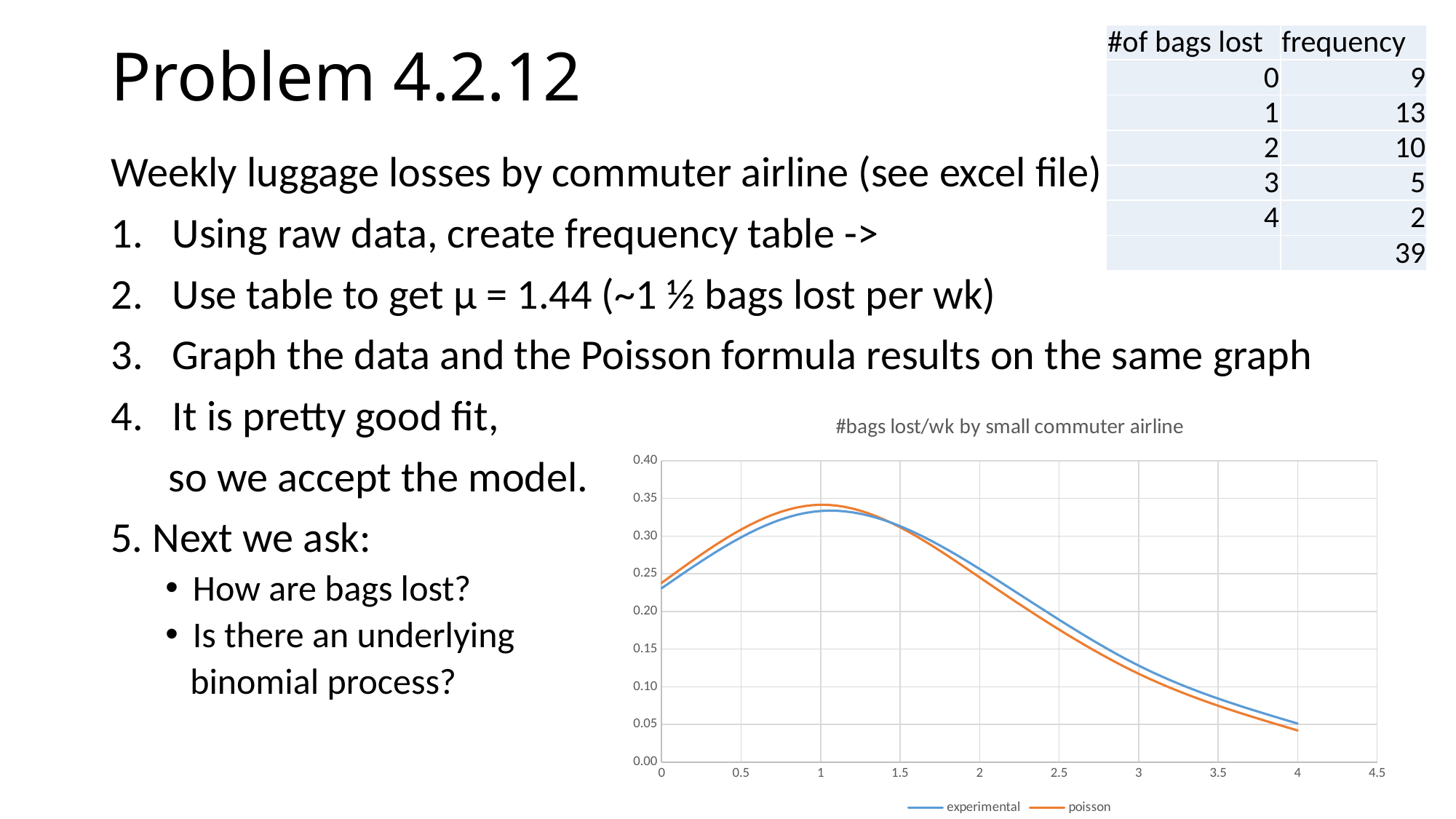
Do the values of the experimental series rise or fall between x = 1 and x = 4? fall Is the value of the experimental series at x = 4 greater or less than 0.10? less Is the value of the experimental series at x = 1 greater or less than 0.30? greater What kind of chart is shown on the slide? line chart Do the values of the poisson series rise or fall between x = 0 and x = 1? rise Is the value of the poisson series at x = 4 greater or less than 0.05? less Which series is drawn in orange in the chart? poisson What is the title of the chart? #bags lost/wk by small commuter airline How many series does the chart legend list? 2